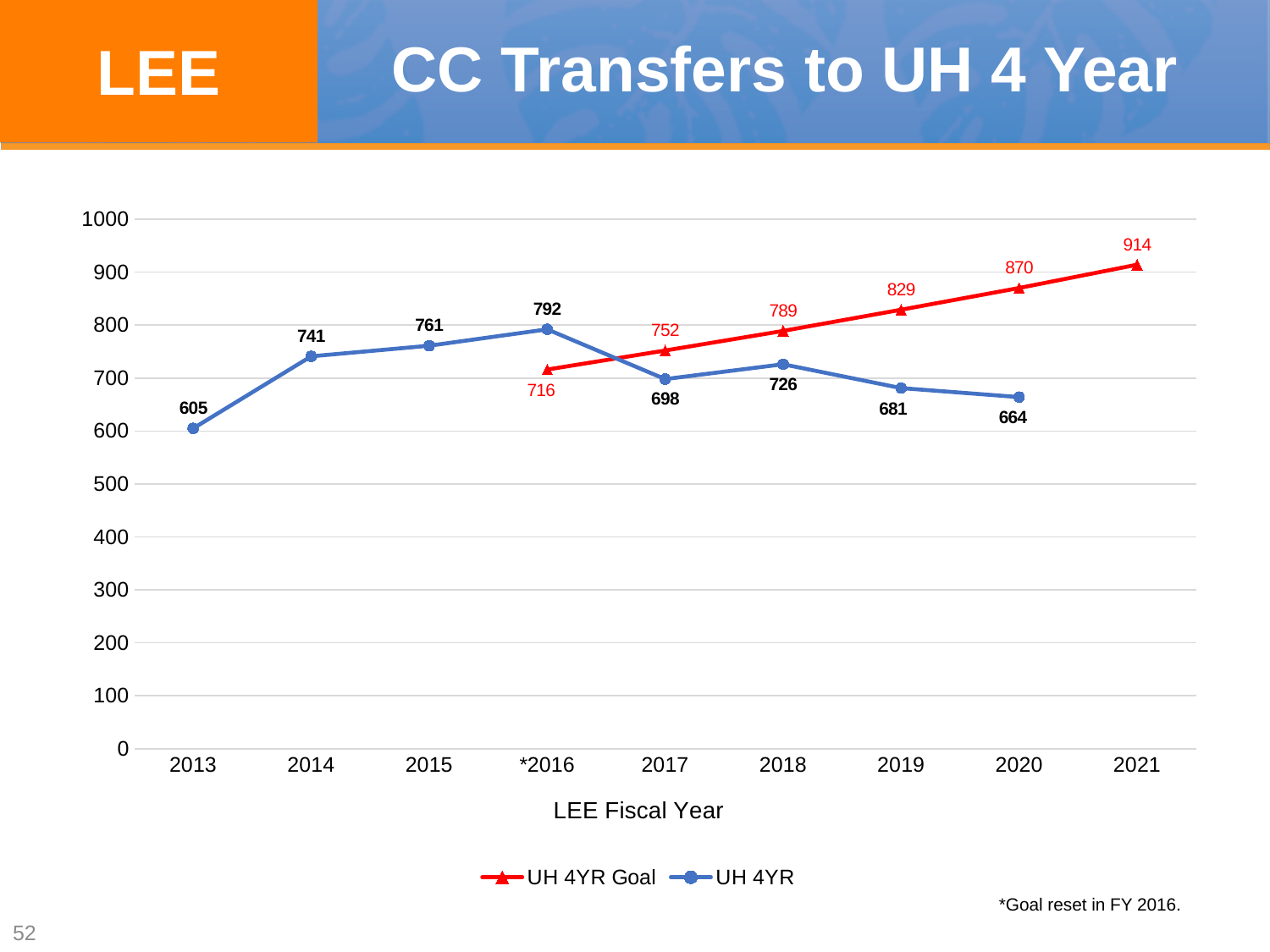
What is the difference between the UH 4YR Goal and the UH 4YR value in 2020? 206 How many series does the legend list? 2 What is the UH 4YR Goal value for 2019? 829 Which year has the lowest UH 4YR value? 2013 What is the UH 4YR Goal value for 2021? 914 Which year has the highest UH 4YR value? *2016 What kind of chart is shown on the slide? Line chart What is the x-axis title of the chart? LEE Fiscal Year What is the UH 4YR value for *2016? 792 In 2017, which is larger: the UH 4YR Goal or the UH 4YR value? UH 4YR Goal Does the UH 4YR Goal series rise or fall from *2016 to 2021? Rise What is the UH 4YR value for 2013? 605